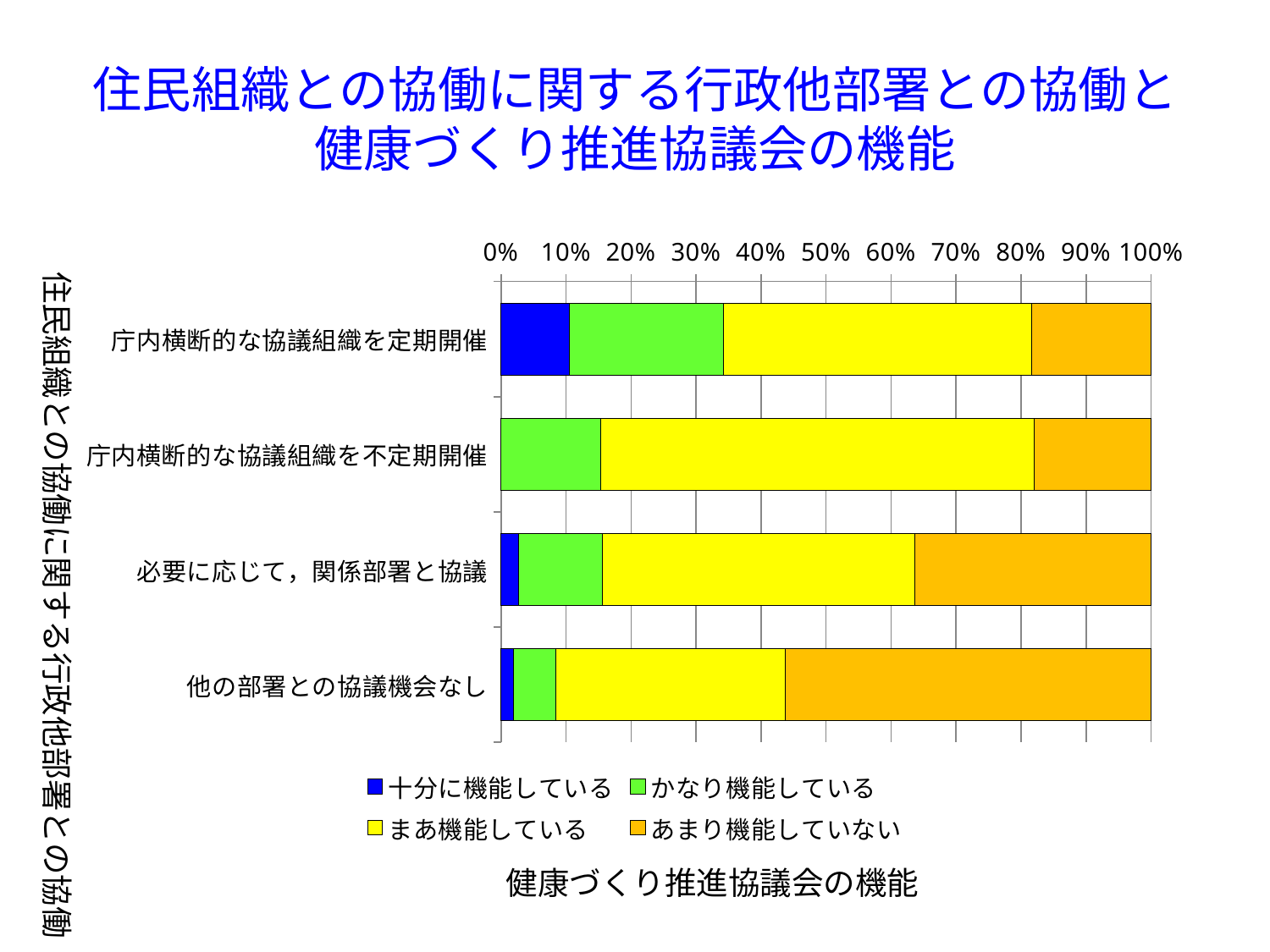
What kind of chart is shown on the slide? bar chart How many series does the legend list? 4 Which category has the largest あまり機能していない segment? 他の部署との協議機会なし Which category has the smallest まあ機能している segment? 他の部署との協議機会なし Which category has the largest 十分に機能している segment? 庁内横断的な協議組織を定期開催 Is the かなり機能している value for 庁内横断的な協議組織を定期開催 greater or less than 30%? less How many categories are plotted on the vertical axis of the chart? 4 Is the あまり機能していない value for 他の部署との協議機会なし greater or less than 50%? greater Is the 十分に機能している value for 庁内横断的な協議組織を定期開催 greater or less than 20%? less What is the title shown below the legend on the horizontal axis of the chart? 健康づくり推進協議会の機能 Which has the larger あまり機能していない segment: 他の部署との協議機会なし or 庁内横断的な協議組織を定期開催? 他の部署との協議機会なし